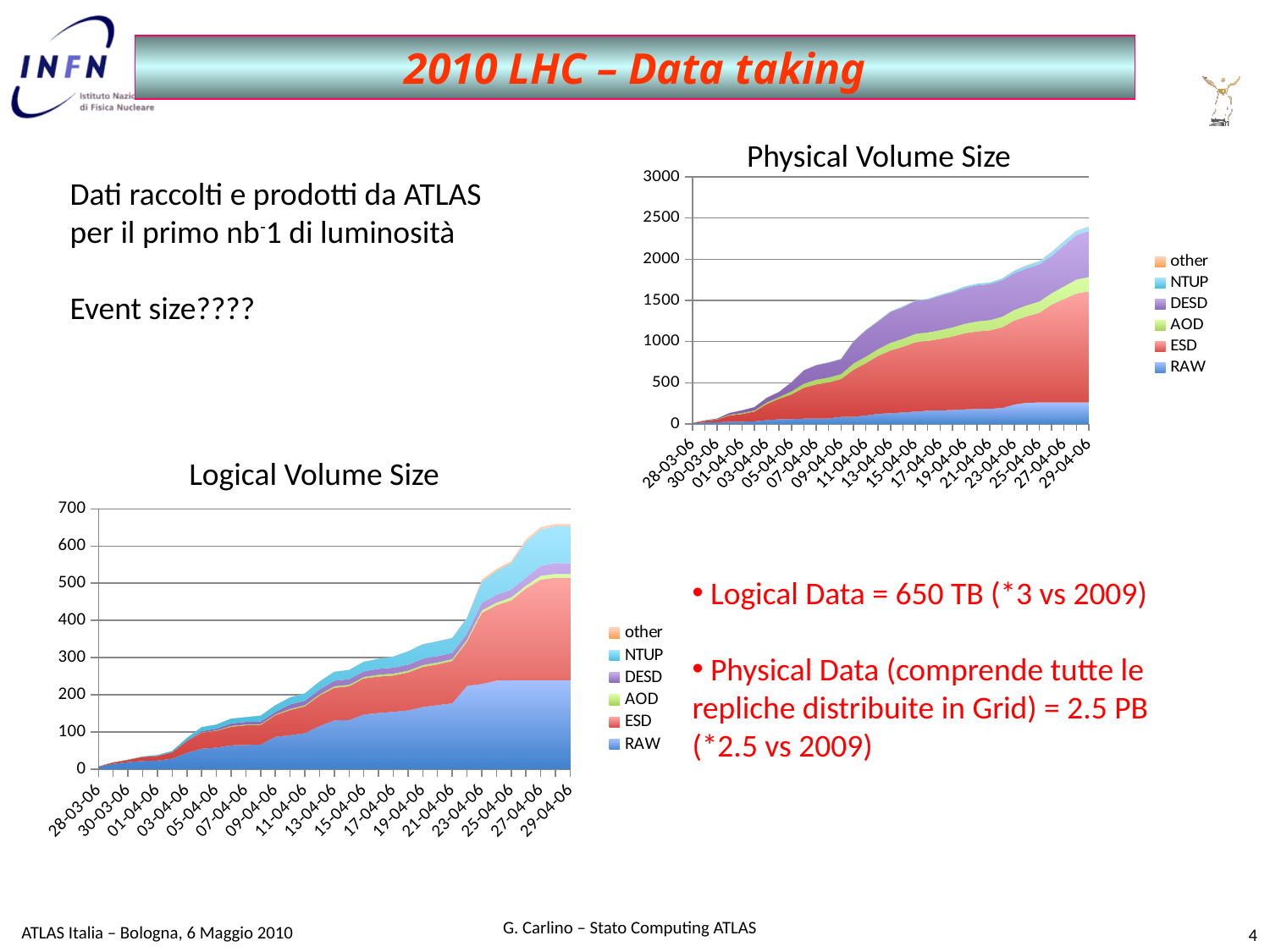
What type of chart is the 'Physical Volume Size' chart? stacked area chart In the 'Logical Volume Size' chart, is the RAW value at 29-04-06 greater or less than 200? greater In the 'Physical Volume Size' chart, is the total stacked value at 29-04-06 greater or less than 2000? greater In the 'Physical Volume Size' chart, is the RAW value at 29-04-06 greater or less than 500? less In the 'Physical Volume Size' chart, does the total volume rise or fall over the period shown? rise What is the highest value shown on the y axis of the 'Physical Volume Size' chart? 3000 What type of chart is the 'Logical Volume Size' chart? stacked area chart How many series does the legend of the 'Physical Volume Size' chart list? 6 In the 'Logical Volume Size' chart, does the total volume rise or fall from 28-03-06 to 29-04-06? rise How many series does the legend of the 'Logical Volume Size' chart list? 6 Which series is at the bottom of the stack in the 'Logical Volume Size' chart? RAW